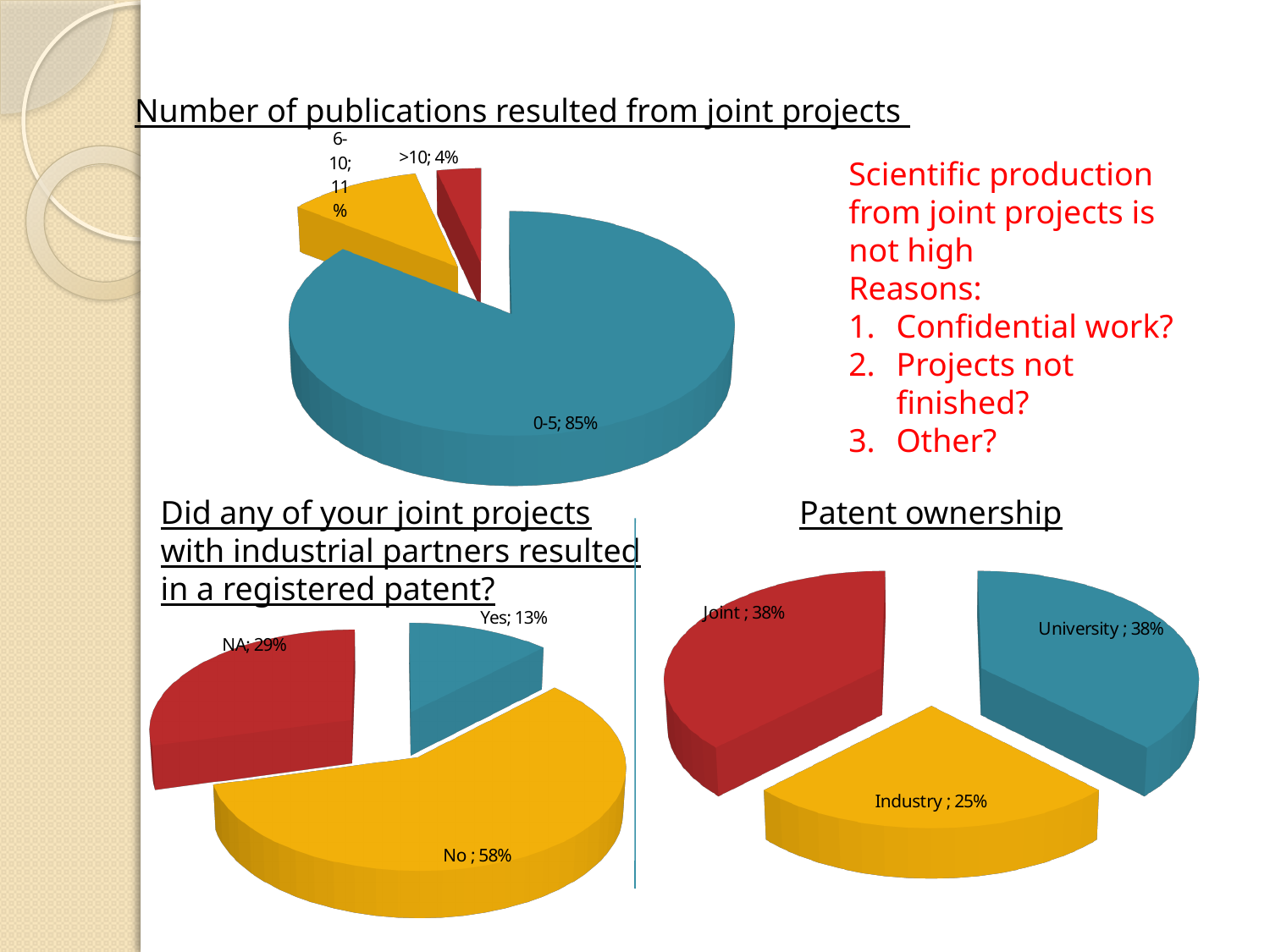
In the 'Number of publications resulted from joint projects' chart, what share reported more than 10 publications? 4% In the 'Did any of your joint projects with industrial partners resulted in a registered patent?' chart, what share answered 'No'? 58% In the 'Did any of your joint projects with industrial partners resulted in a registered patent?' chart, what is the difference in percentage points between 'NA' and 'Yes'? 16 In the 'Number of publications resulted from joint projects' chart, how many slices does the pie have? 3 In the 'Number of publications resulted from joint projects' chart, what share of respondents reported 0-5 publications? 85% In the 'Did any of your joint projects with industrial partners resulted in a registered patent?' chart, which answer has the largest share? No In the 'Did any of your joint projects with industrial partners resulted in a registered patent?' chart, what share answered 'Yes'? 13% What type of chart is used for 'Patent ownership'? Pie chart In the 'Number of publications resulted from joint projects' chart, which category has the smallest share? >10 In the 'Patent ownership' chart, is the share for University larger or smaller than the share for Industry? larger In the 'Patent ownership' chart, which has the smallest share: Joint, University or Industry? Industry In the 'Patent ownership' chart, what share is owned by Industry? 25%